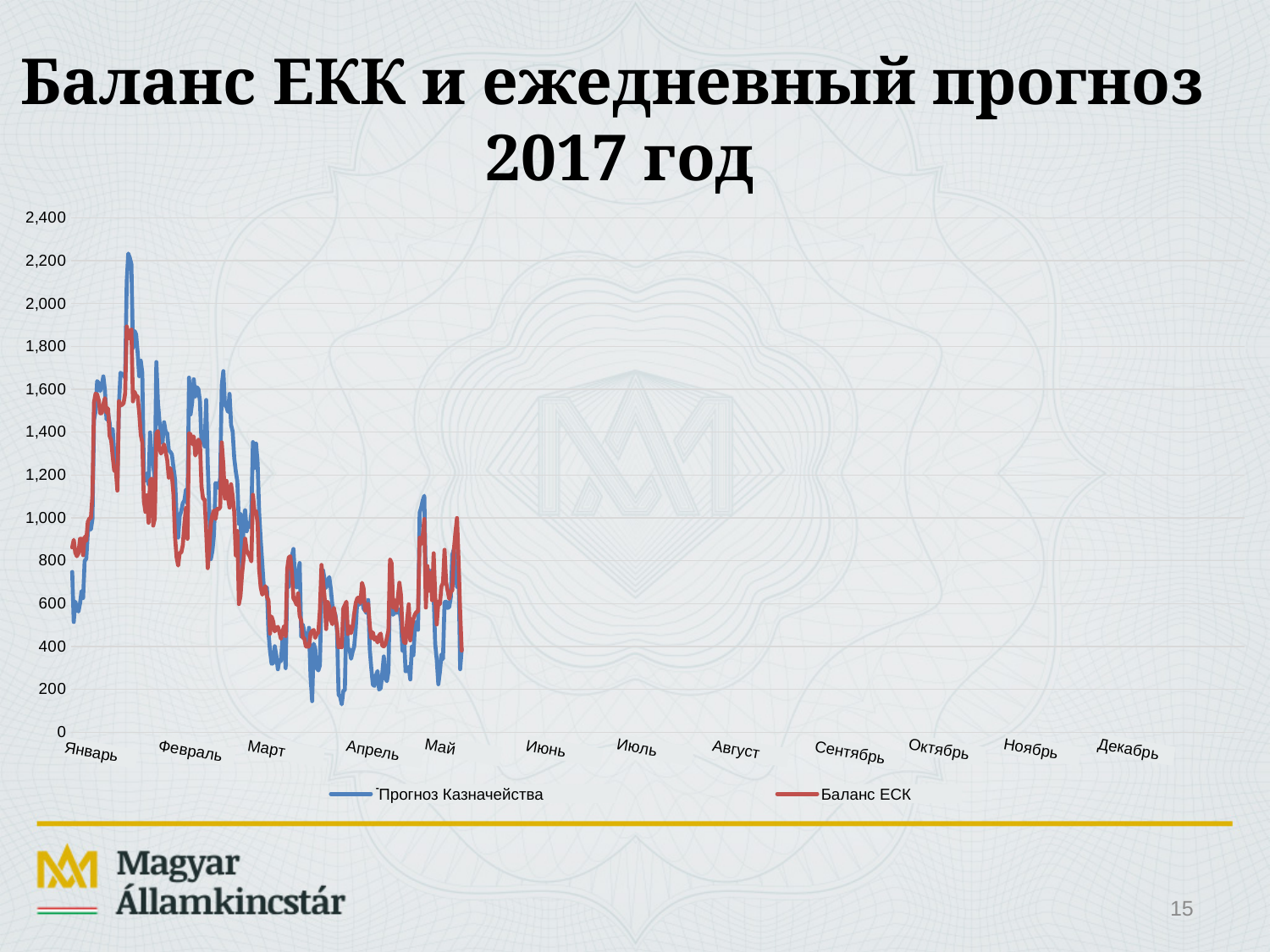
Which month is the last one with plotted data? Май Is the highest value of the Прогноз Казначейства series greater or less than 2,000? greater What is the highest value shown on the y axis? 2,400 What kind of chart is shown on the slide? line chart Which series is drawn in red? Баланс ЕСК How many series does the legend list? 2 Is the highest value of the Баланс ЕСК series greater or less than 2,000? less How many months are labelled along the x axis? 12 Which series reaches the higher peak value in January? Прогноз Казначейства Overall, do the plotted values rise or fall from January to May? fall